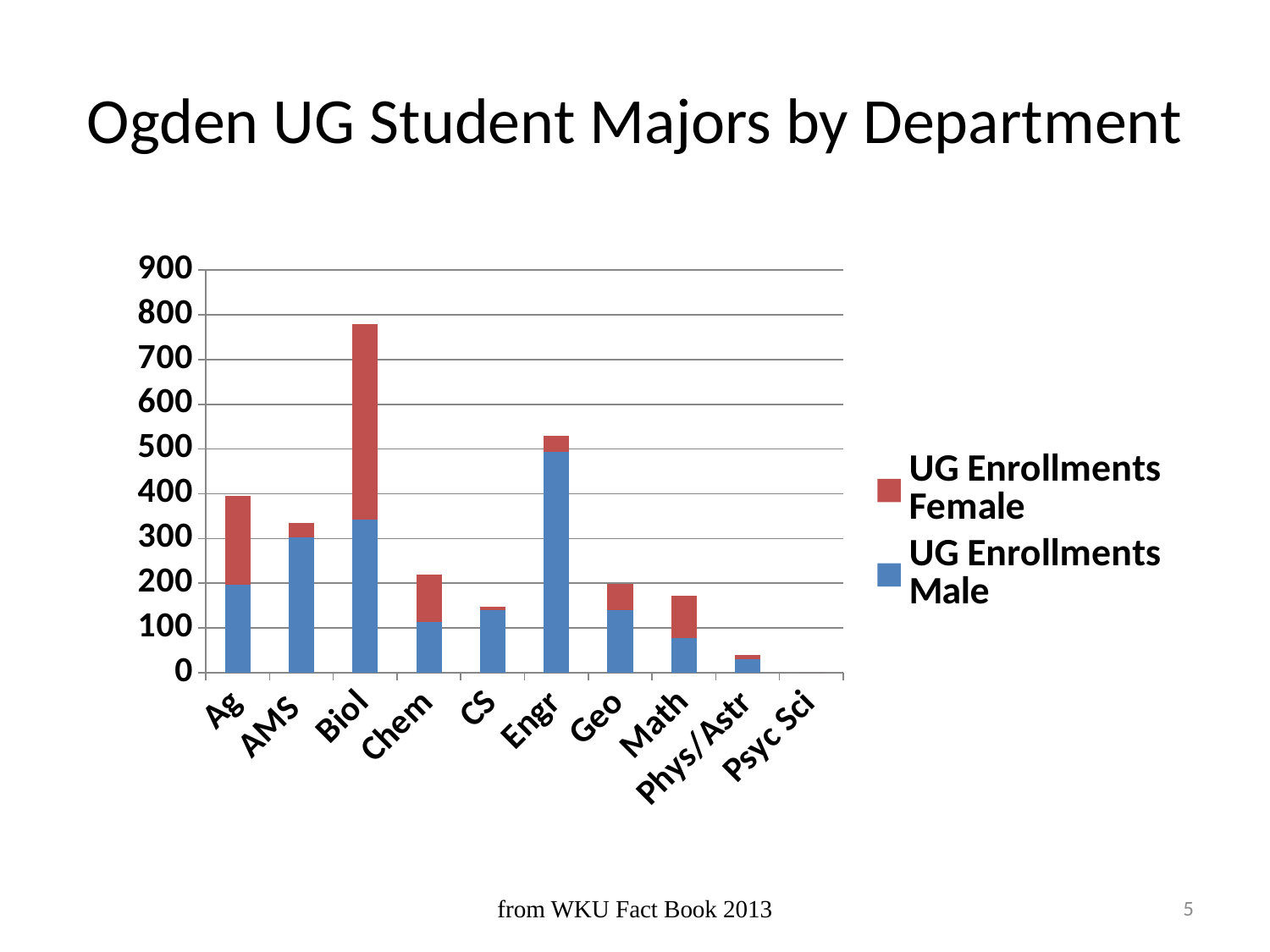
Which has the larger total bar, Engr or Ag? Engr How many departments are listed along the x axis? 10 What kind of chart is shown on the slide? Stacked bar chart Is the UG Enrollments Male value for Engr greater or less than 400? greater Is the total bar height for Biol greater or less than 700? greater Which department has the tallest bar? Biol Is the total bar height for Phys/Astr greater or less than 100? less What is the title of the chart? Ogden UG Student Majors by Department Which department has the larger UG Enrollments Female segment, Biol or Engr? Biol How many series does the legend list? 2